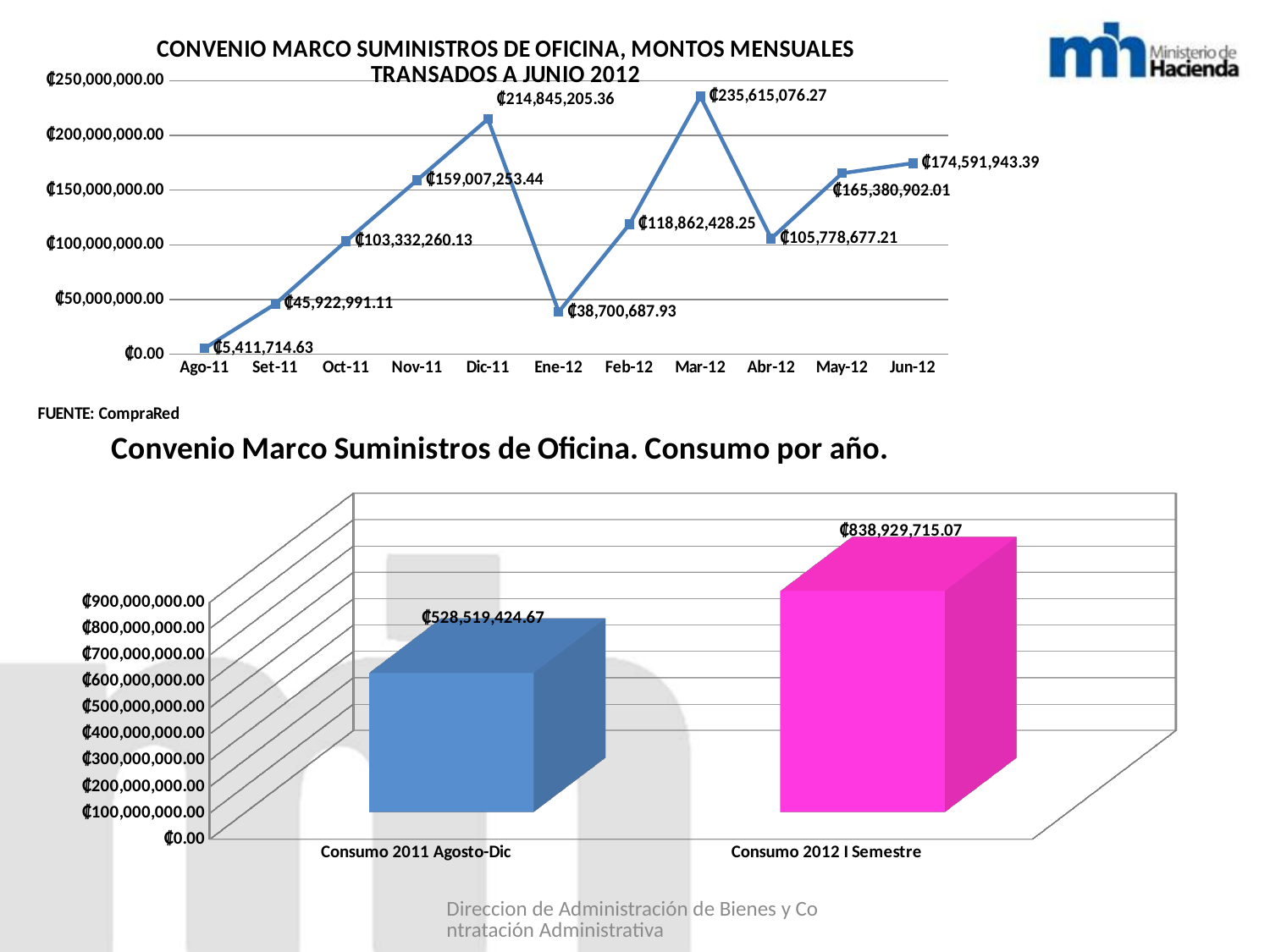
In the top chart (montos mensuales), which month has the highest value? Mar-12 In the bottom chart (Consumo por año), what is the value for Consumo 2012 I Semestre? ₡838,929,715.07 In the top chart (montos mensuales), do the values rise or fall from Ago-11 to Dic-11? rise In the top chart (montos mensuales), how many months are plotted? 11 What kind of chart is the bottom chart (Consumo por año)? bar chart In the top chart (montos mensuales), which month has the lowest value? Ago-11 What kind of chart is the top chart (montos mensuales)? line chart In the top chart (montos mensuales), which is larger, the value for May-12 or the value for Abr-12? May-12 In the top chart (montos mensuales), what is the difference between the values for Mar-12 and Dic-11? ₡20,769,870.91 In the top chart (Convenio Marco Suministros de Oficina, montos mensuales), what is the value for Dic-11? ₡214,845,205.36 In the bottom chart (Consumo por año), what is the difference between Consumo 2012 I Semestre and Consumo 2011 Agosto-Dic? ₡310,410,290.40 In the top chart (montos mensuales), what is the value for Ene-12? ₡38,700,687.93